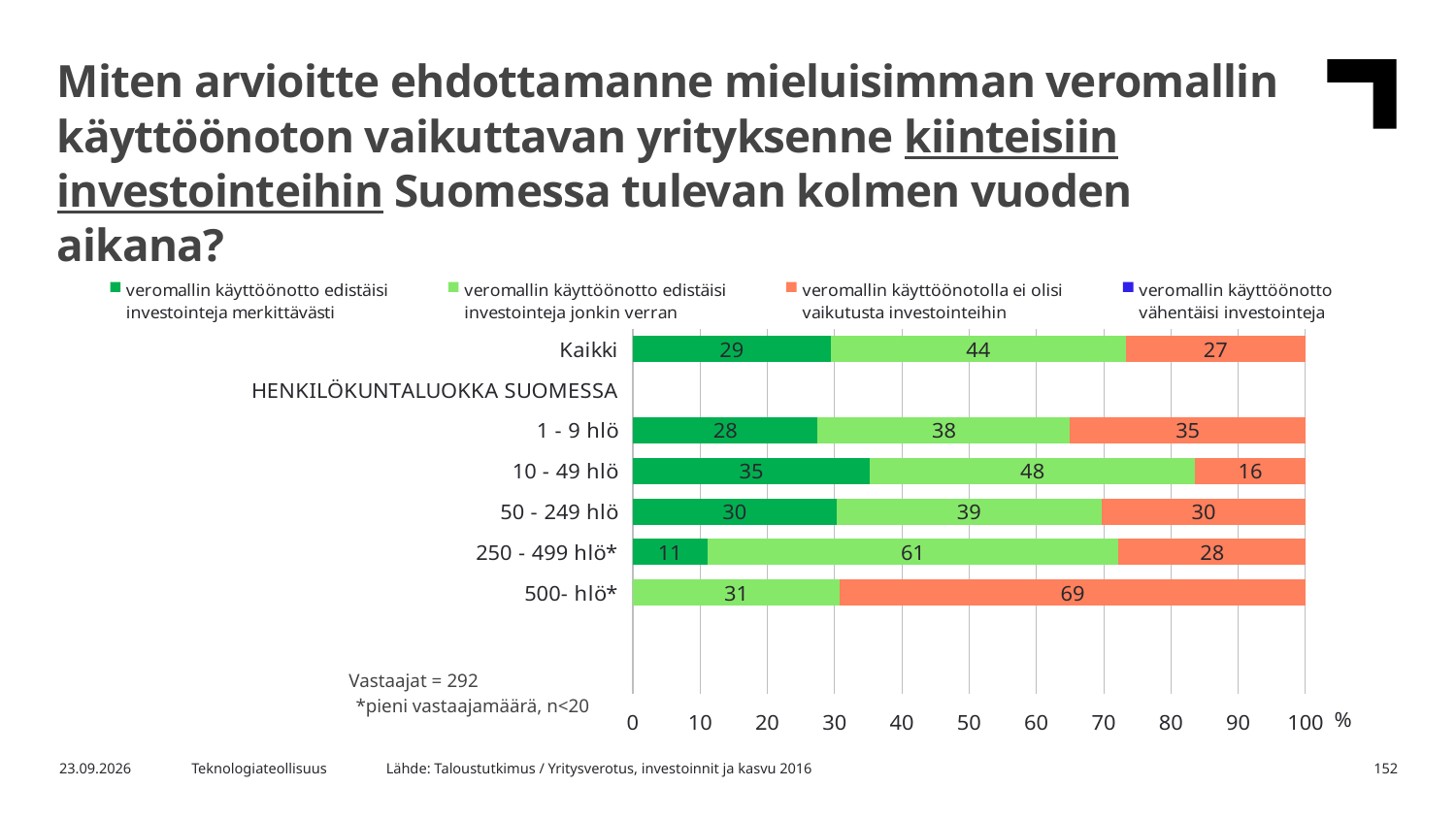
What kind of chart is shown on the slide? stacked bar chart Which category has the highest value for 'veromallin käyttöönotto edistäisi investointeja jonkin verran'? 250 - 499 hlö* What is the value for 'veromallin käyttöönotto edistäisi investointeja merkittävästi' in the 10 - 49 hlö bar? 35 What is the value for 'veromallin käyttöönotolla ei olisi vaikutusta investointeihin' in the 500- hlö* bar? 69 What is the difference between the 'veromallin käyttöönotolla ei olisi vaikutusta investointeihin' values for 1 - 9 hlö and 10 - 49 hlö? 19 What is the number of respondents (Vastaajat) stated on the slide? 292 What is the total of the stacked bar for 1 - 9 hlö? 101 How many series does the legend list? 4 What is the value for 'veromallin käyttöönotto edistäisi investointeja jonkin verran' in the Kaikki bar? 44 Which is larger: the 'veromallin käyttöönotto edistäisi investointeja merkittävästi' value for 50 - 249 hlö or for 250 - 499 hlö*? 50 - 249 hlö How many categories (bars with values) are plotted in the chart? 6 Which category has the lowest value for 'veromallin käyttöönotolla ei olisi vaikutusta investointeihin'? 10 - 49 hlö